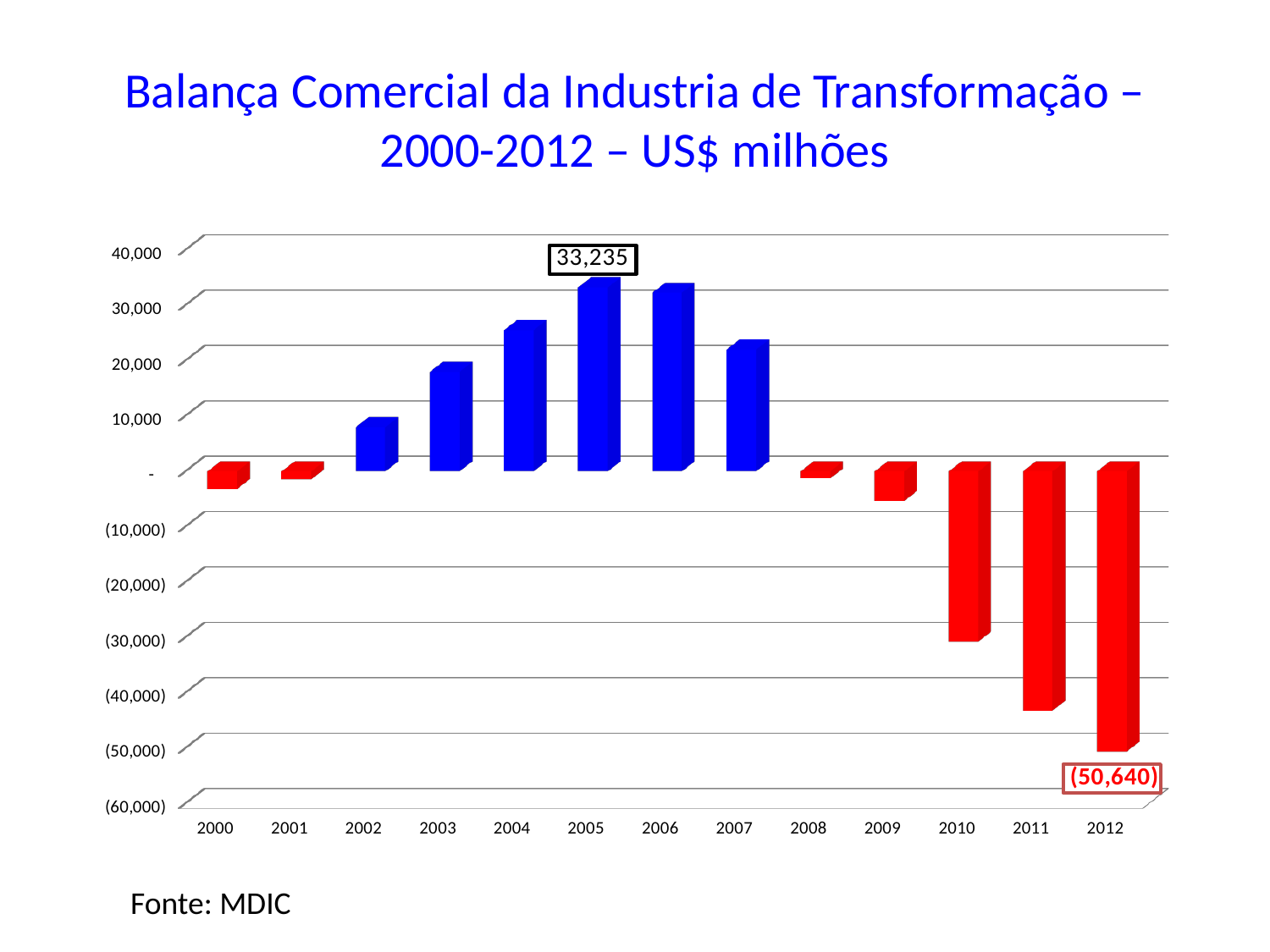
Which year has the highest value? 2005 What is the value for 2012? (50,640) Do the values rise or fall from 2005 to 2012? fall How many years are shown on the x axis? 13 Is the value for 2004 greater or less than 20,000? greater Is the value for 2010 greater or less than (20,000)? less What kind of chart is this? bar chart What is the value for 2005? 33,235 What is the difference between the value for 2005 and the value for 2012? 83,875 Which year has the lowest value? 2012 What colour are the bars with negative values? red Which year has the larger value, 2006 or 2007? 2006